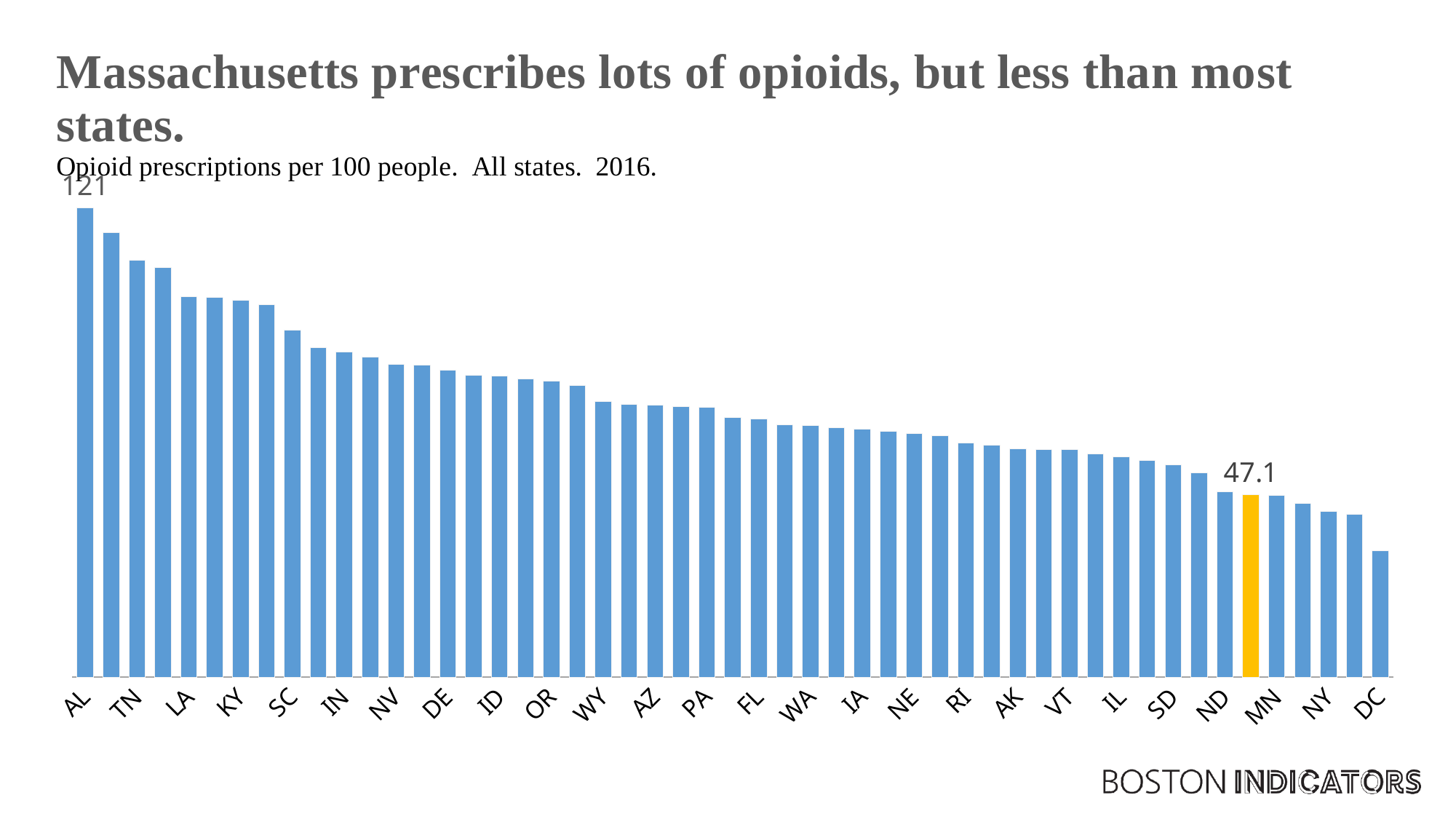
What is the title of the slide? Massachusetts prescribes lots of opioids, but less than most states. What colour is the highlighted bar that differs from the others? orange Which has a larger value, TN or NY? TN Which has a larger value, DC or MN? MN What kind of chart is shown on the slide? bar chart Which state has the highest number of opioid prescriptions per 100 people? AL Which labeled category has the lowest bar on the chart? DC Do the bar values rise or fall moving from left to right along the x axis? fall What is the value labeled on the bar for AL? 121 Which has a larger value, SC or WA? SC What is the difference between the value labeled for AL and the value labeled on the orange highlighted bar? 73.9 What value is labeled on the orange highlighted bar? 47.1